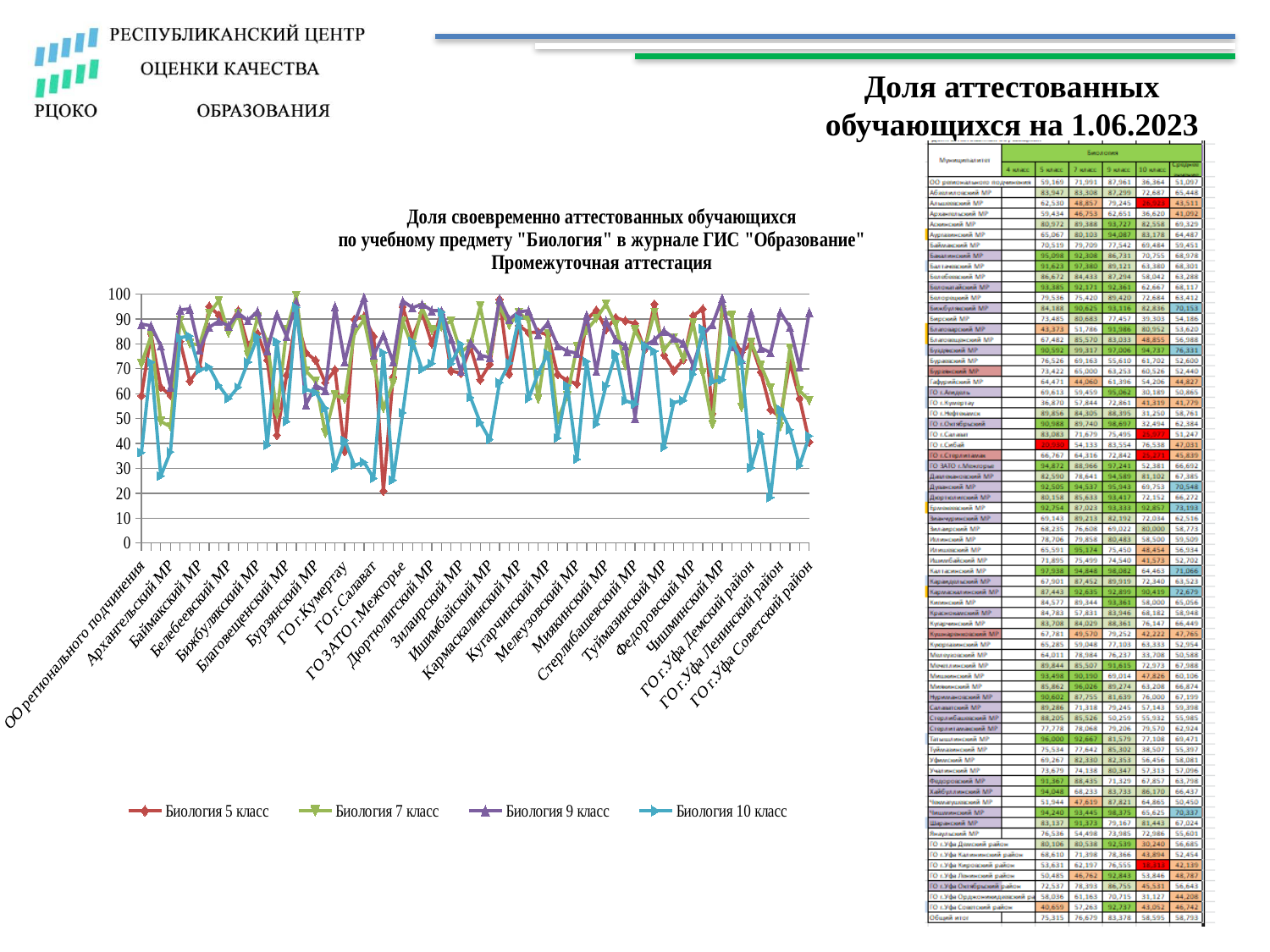
Is the value of Биология 10 класс for ОО регионального подчинения greater or less than 50? less Is the value of Биология 5 класс for ГО г.Уфа Советский район greater or less than 50? less Is the value of Биология 9 класс for ГО г.Уфа Советский район greater or less than 80? greater For ГО г.Уфа Советский район, which is larger: Биология 9 класс or Биология 10 класс? Биология 9 класс Which series are listed in the legend of the line chart? Биология 5 класс, Биология 7 класс, Биология 9 класс, Биология 10 класс For ОО регионального подчинения, which is larger: Биология 9 класс or Биология 5 класс? Биология 9 класс For ОО регионального подчинения, which series has the lowest value? Биология 10 класс How many series does the legend of the line chart list? 4 What is the highest value shown on the vertical axis of the line chart? 100 What kind of chart is shown on the slide? line chart